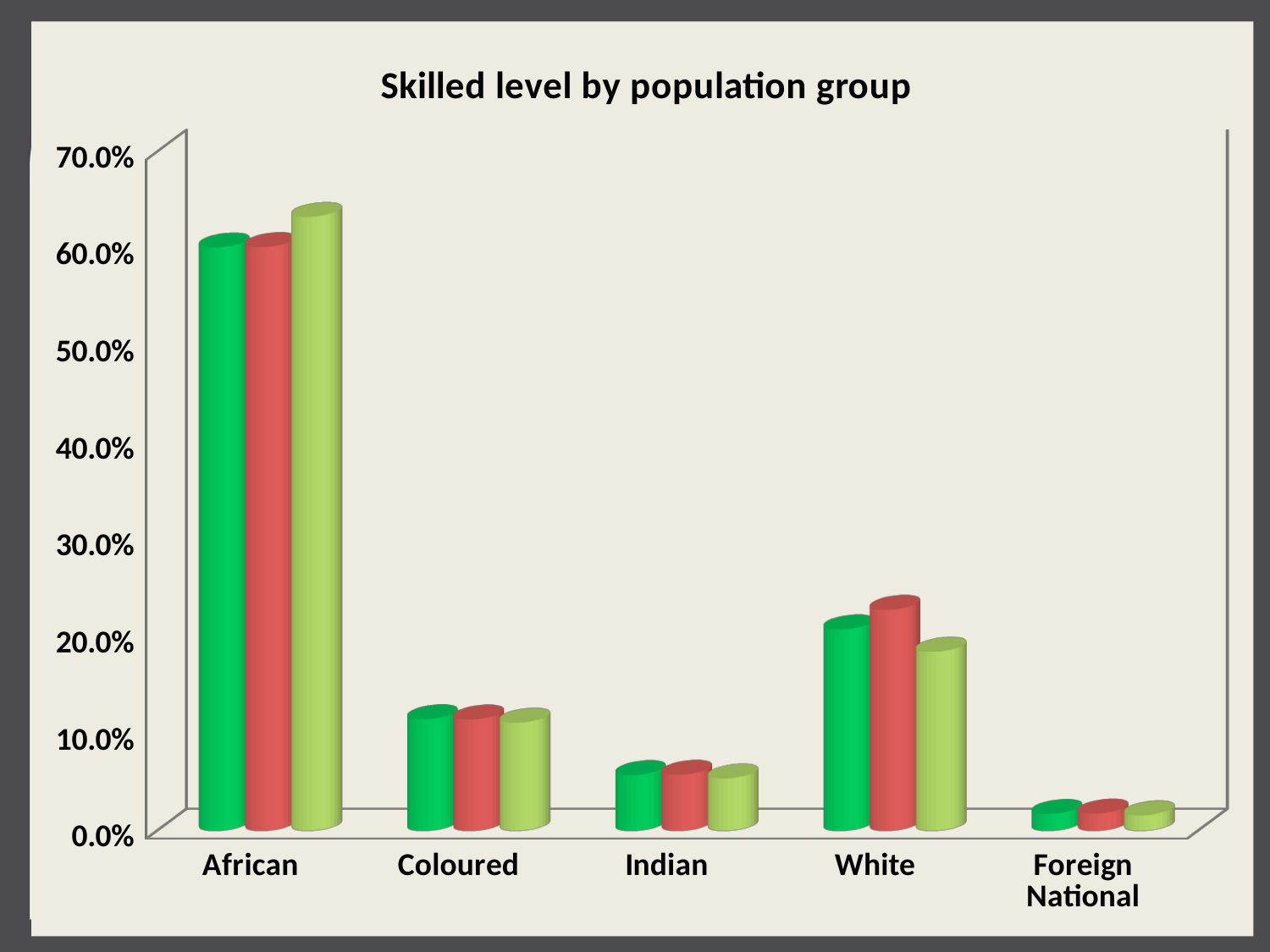
What is the title of the chart? Skilled level by population group Which population group has the highest skilled level? African Is the value of the red bar for African greater or less than 50.0%? greater Which has the higher skilled level, Coloured or Indian? Coloured How many bars are shown for each population group? 3 Which population group has the lowest skilled level? Foreign National How many population groups are shown on the x axis? 5 Is the value of the light green bar for White greater or less than 30.0%? less Which has the higher skilled level, White or Coloured? White What kind of chart is shown on the slide? bar chart Is the value of the dark green bar for Indian greater or less than 10.0%? less